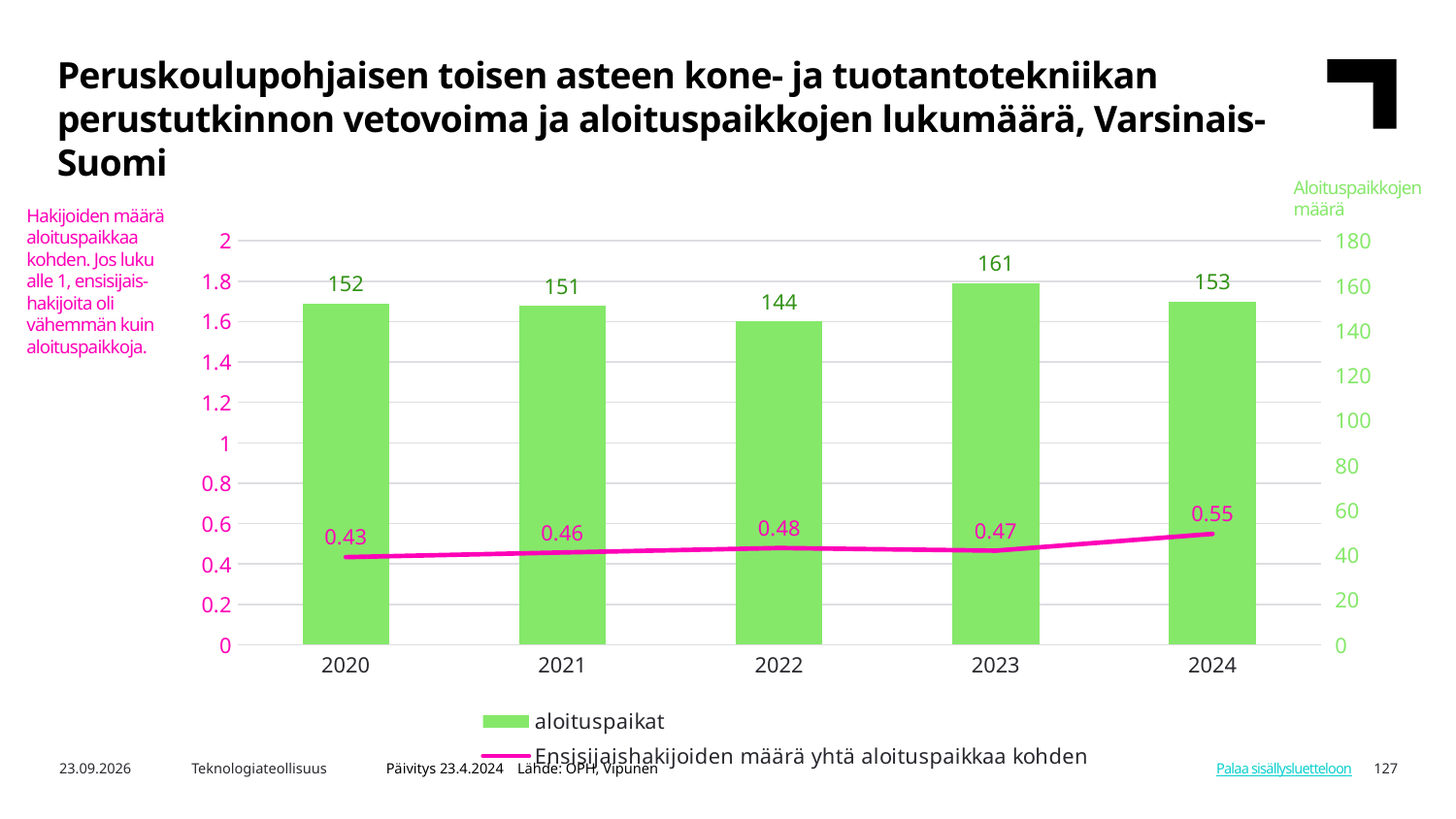
What is the value of aloituspaikat in 2023? 161 Does Ensisijaishakijoiden määrä yhtä aloituspaikkaa kohden rise or fall from 2020 to 2024? Rise How many years are shown on the x axis? 5 What is the value of Ensisijaishakijoiden määrä yhtä aloituspaikkaa kohden in 2024? 0.55 In which year is aloituspaikat highest? 2023 In which year is aloituspaikat lowest? 2022 What is the difference between aloituspaikat in 2023 and in 2022? 17 In which year is Ensisijaishakijoiden määrä yhtä aloituspaikkaa kohden lowest? 2020 What kinds of chart are combined on this slide? Bar chart and line chart What is the value of aloituspaikat in 2022? 144 How many series does the legend list? 2 Which year has a higher value of aloituspaikat, 2020 or 2024? 2024